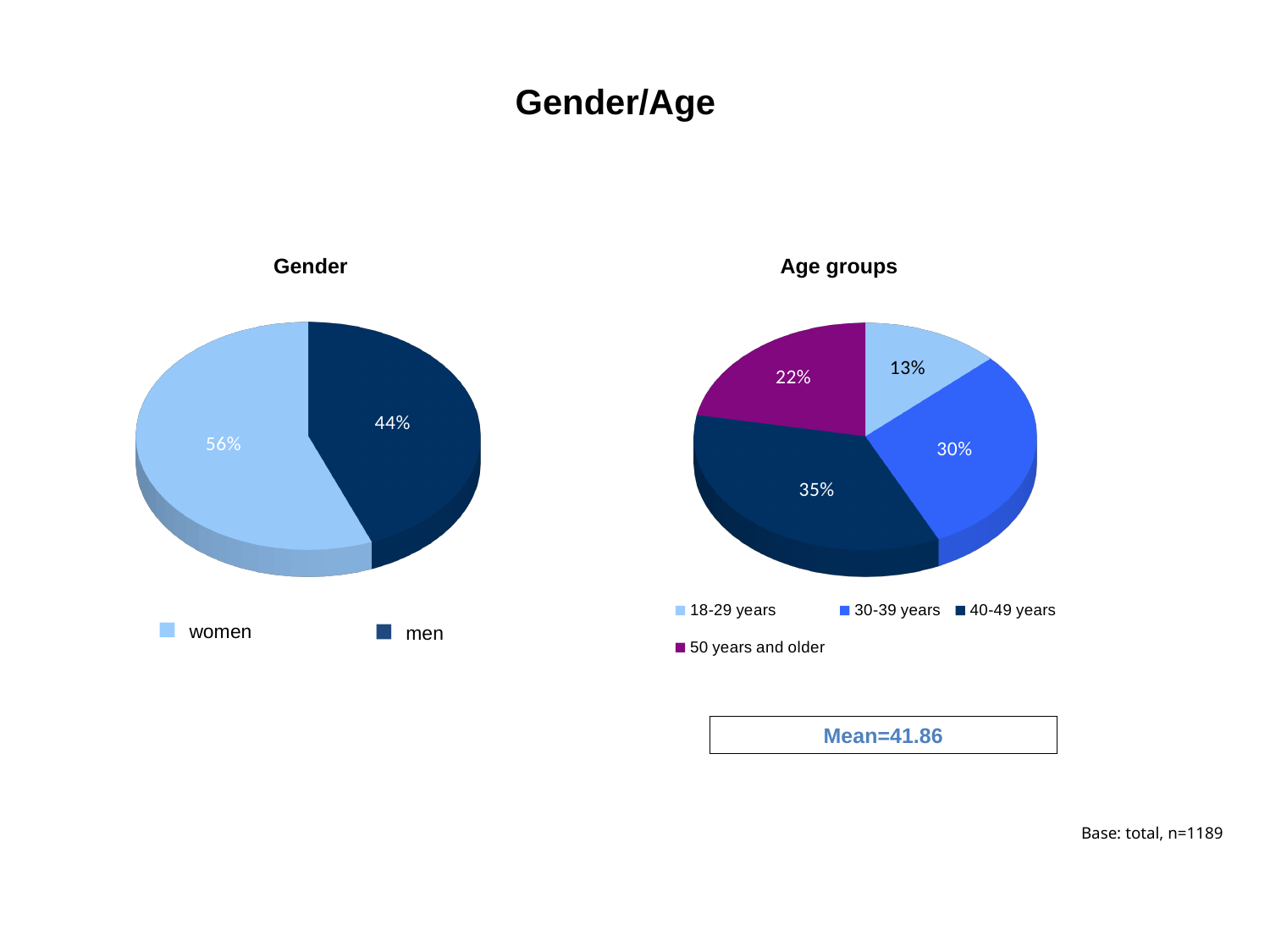
What kind of chart is the Gender chart? pie chart In the Age groups chart, what share of respondents are 40-49 years? 35% In the Gender chart, what share of respondents are men? 44% In the Age groups chart, what share of respondents are 18-29 years? 13% In the Age groups chart, how many age groups are shown? 4 In the Gender chart, what share of respondents are women? 56% In the Gender chart, which group is larger, women or men? women In the Gender chart, what is the difference in percentage points between women and men? 12 In the Age groups chart, which age group has the smallest share? 18-29 years In the Age groups chart, which age group has the largest share? 40-49 years In the Age groups chart, which colour represents the 50 years and older group? purple In the Age groups chart, what is the difference in percentage points between the 30-39 years and 50 years and older groups? 8